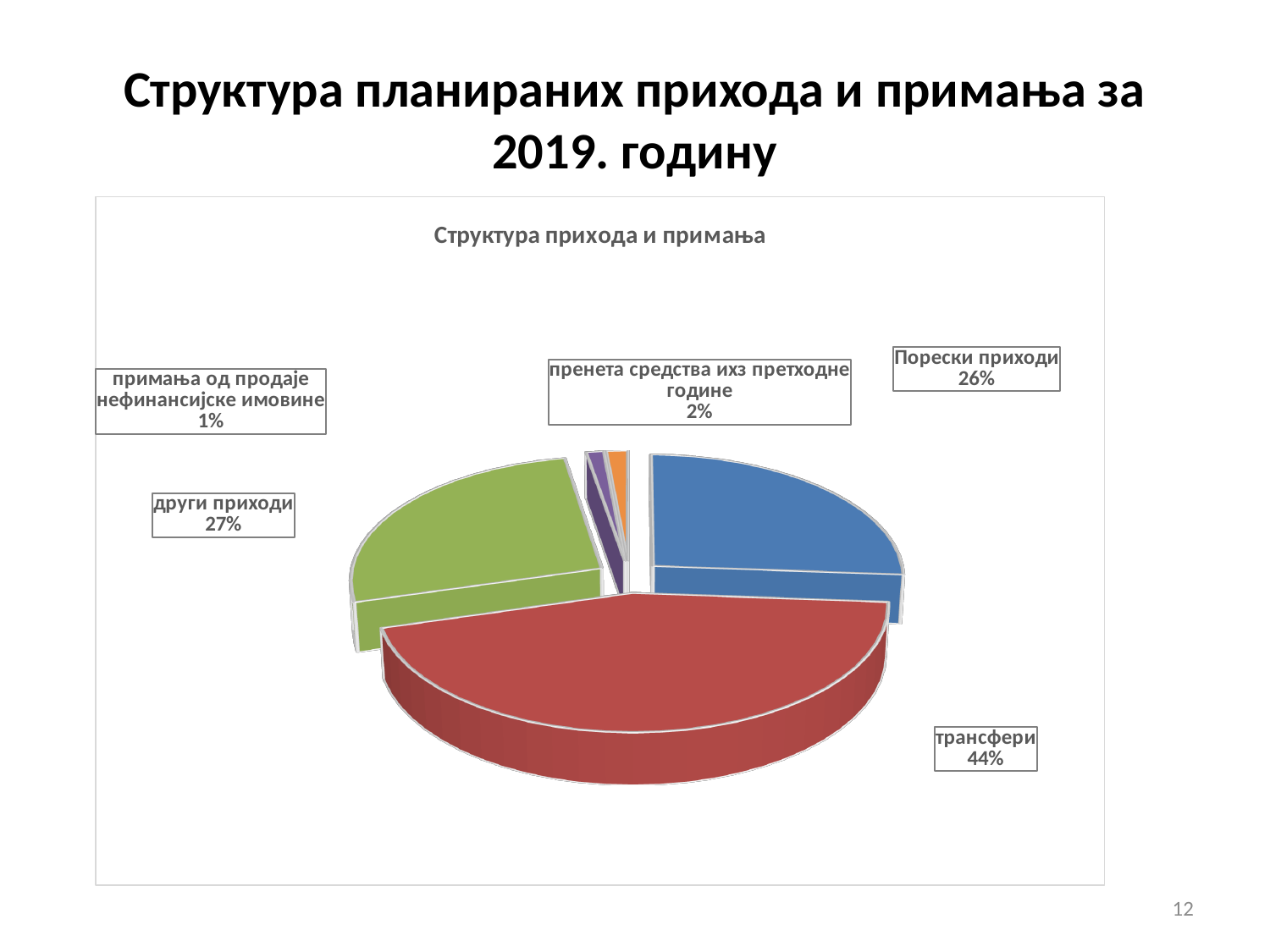
What share of the pie is примања од продаје нефинансијске имовине? 1% What share of the pie is трансфери? 44% Which category has the smallest share of the pie? примања од продаје нефинансијске имовине How many slices does the pie chart have? 5 What is the title of the chart? Структура прихода и примања Which category has the largest share of the pie? трансфери What share of the pie is пренета средства ихз претходне године? 2% What is the difference in percentage points between трансфери and Порески приходи? 18 Which is larger, the share for други приходи or the share for Порески приходи? други приходи What kind of chart is shown on the slide? pie chart